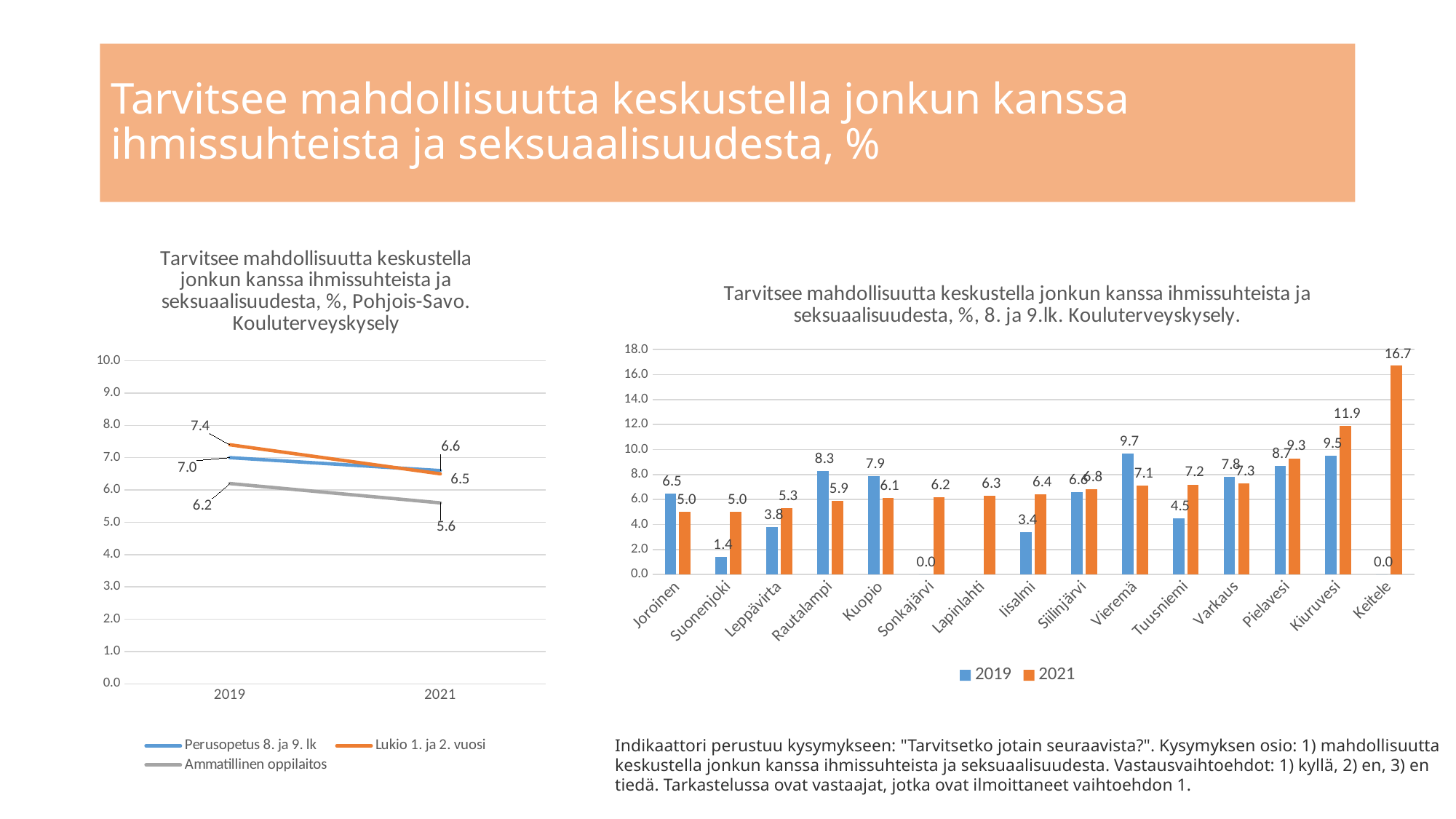
What kind of chart is the right-hand chart (8. ja 9.lk. by municipality)? Bar chart In the right-hand chart (8. ja 9.lk. by municipality), which is larger for Rautalampi: the 2019 value or the 2021 value? 2019 In the left-hand chart (Pohjois-Savo), what is the 2021 value for Ammatillinen oppilaitos? 5.6 In the right-hand chart (8. ja 9.lk. by municipality), what is the difference between the 2021 and 2019 values for Kiuruvesi? 2.4 In the right-hand chart (8. ja 9.lk. by municipality), what is the 2019 value for Vieremä? 9.7 In the right-hand chart (8. ja 9.lk. by municipality), which municipality has the lowest 2019 value among those with a non-zero 2019 bar? Suonenjoki In the right-hand chart (8. ja 9.lk. by municipality), how many municipalities are shown on the x axis? 15 In the right-hand chart (8. ja 9.lk. by municipality), how many series does the legend list? 2 In the left-hand chart (Pohjois-Savo), does the Lukio 1. ja 2. vuosi series rise or fall from 2019 to 2021? Fall In the right-hand chart (8. ja 9.lk. by municipality), what is the 2021 value for Keitele? 16.7 In the left-hand chart (Pohjois-Savo), what is the difference between the 2019 and 2021 values for Perusopetus 8. ja 9. lk? 0.4 In the right-hand chart (8. ja 9.lk. by municipality), which municipality has the highest 2021 value? Keitele